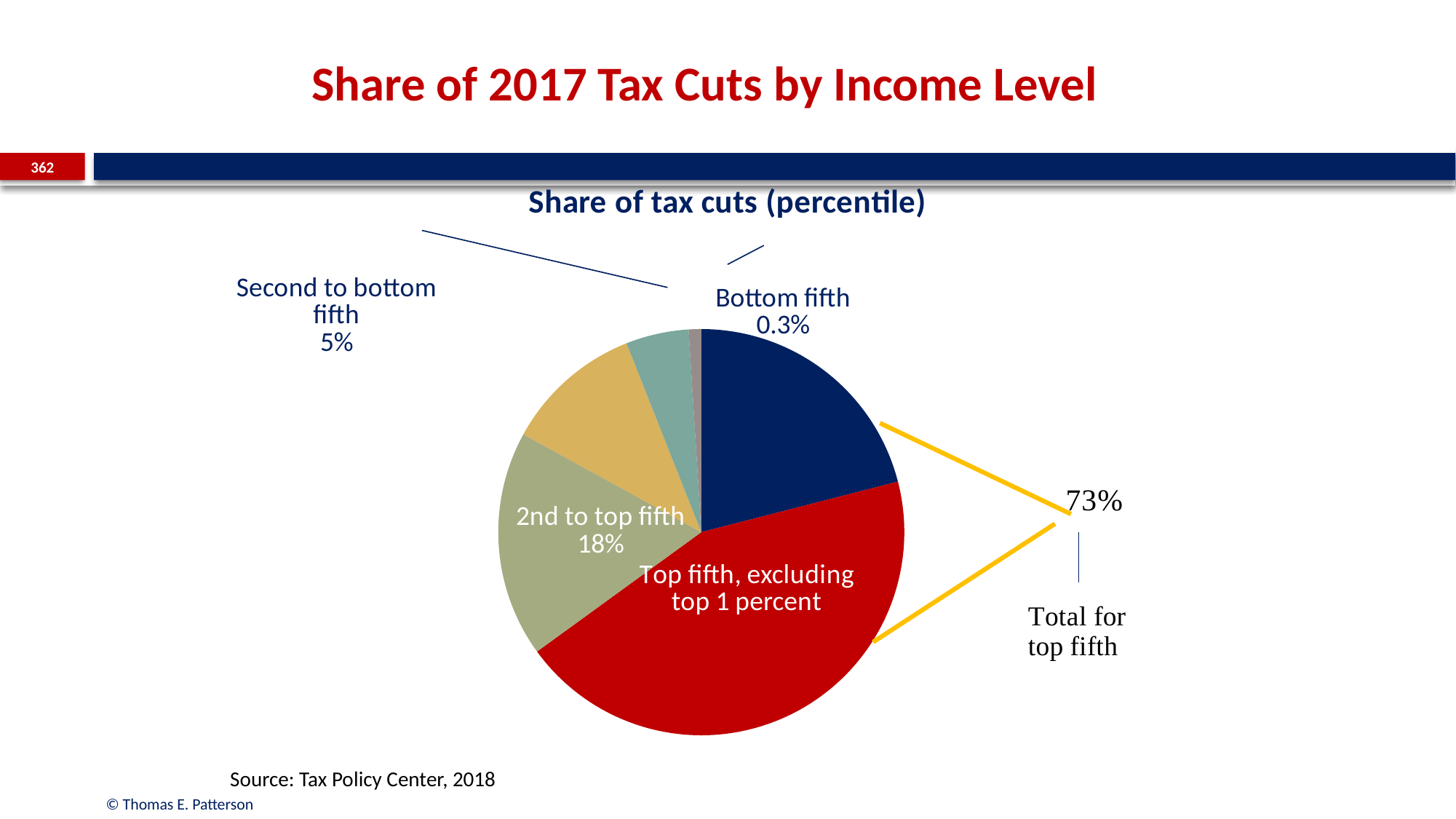
What share of the tax cuts went to the 2nd to top fifth? 18% What share of the tax cuts went to the second to bottom fifth? 5% What is the total share of the tax cuts for the top fifth? 73% Which labeled slice of the pie is the smallest? Bottom fifth Which received a larger share of the tax cuts, the 2nd to top fifth or the second to bottom fifth? 2nd to top fifth What kind of chart is shown on the slide? Pie chart What is the title of the pie chart? Share of tax cuts (percentile) What share of the tax cuts went to the bottom fifth? 0.3% How many percentage points larger is the total for the top fifth than the share for the 2nd to top fifth? 55 percentage points How many percentage points larger is the 2nd to top fifth's share than the second to bottom fifth's share? 13 percentage points What source is cited for the chart? Tax Policy Center, 2018 Which labeled slice of the pie is the largest? Top fifth, excluding top 1 percent